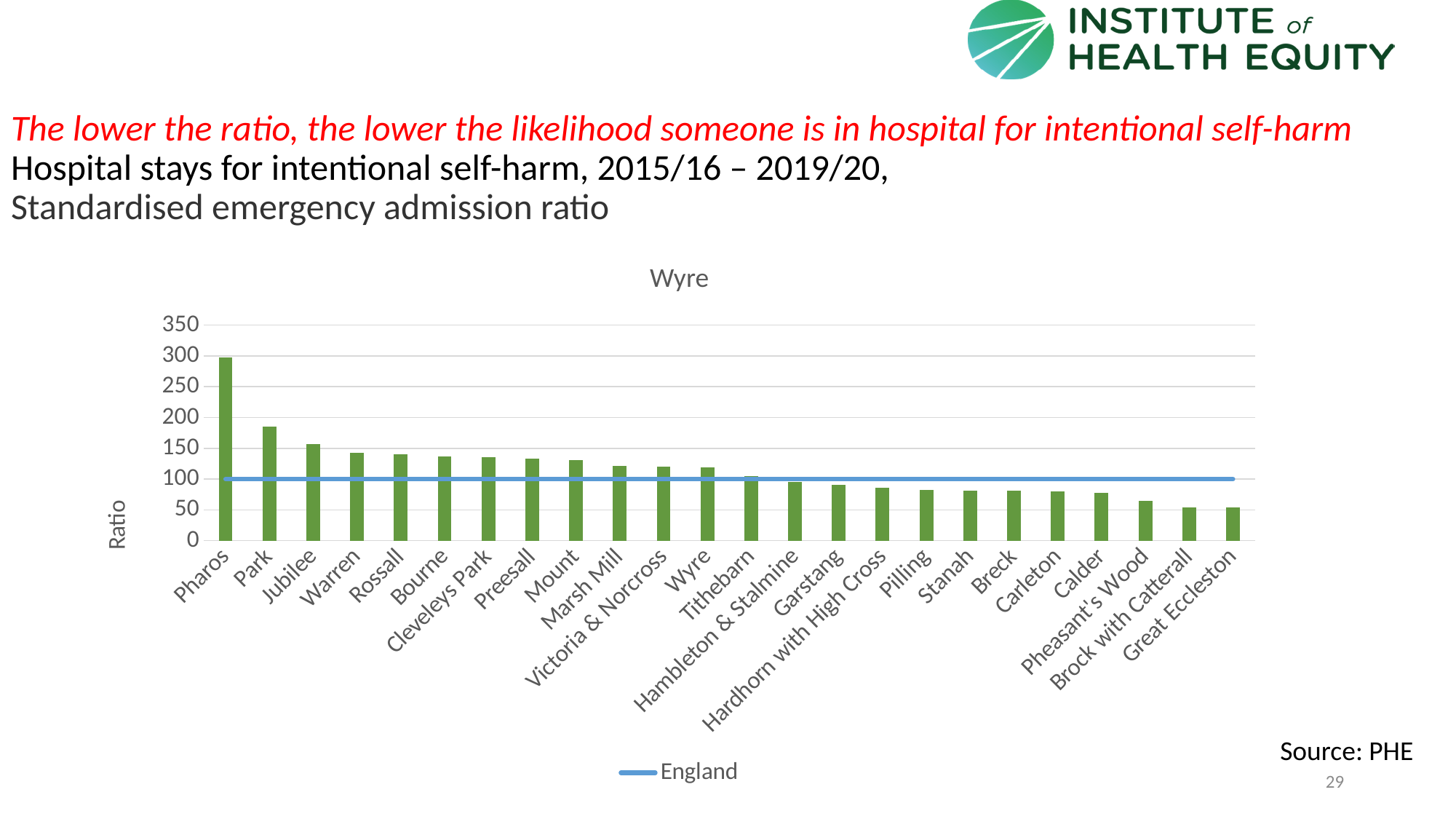
What kind of chart is shown on the slide? bar chart How many entries does the chart's legend list? 1 Which area has the highest ratio in the chart? Pharos Is the value for Pharos greater or less than 250? greater Is the value for Pheasant's Wood greater or less than 100? less Is the value for Great Eccleston greater or less than 100? less How many categories (areas) are plotted on the x axis of the chart? 24 Do the bar values rise or fall moving from left to right along the x axis? fall Which has the larger ratio, Warren or Pilling? Warren What is the label on the vertical axis of the chart? Ratio What is the title of the chart? Wyre